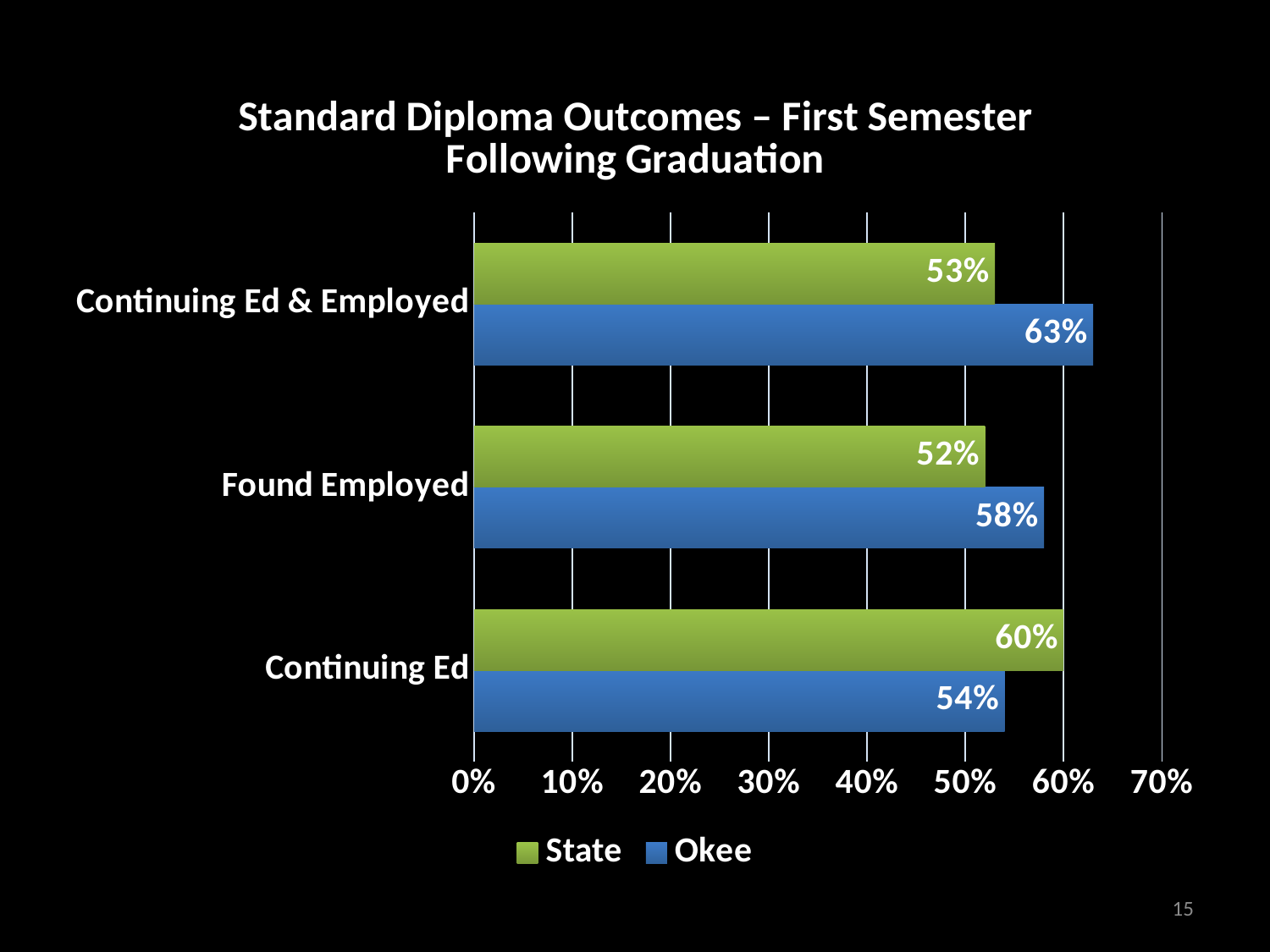
Is the Okee value for Continuing Ed & Employed greater or less than 60%? greater What is the title of the chart? Standard Diploma Outcomes – First Semester Following Graduation How many categories are shown on the chart? 3 How many series does the legend list? 2 For Continuing Ed, which series has the larger value, State or Okee? State What kind of chart is shown on the slide? Bar chart What is the Okee value for Continuing Ed? 54% What is the State value for Found Employed? 52% What is the difference between the Okee and State values for Found Employed? 6% Which category has the highest Okee value? Continuing Ed & Employed Which category has the lowest State value? Found Employed What is the Okee value for Continuing Ed & Employed? 63%